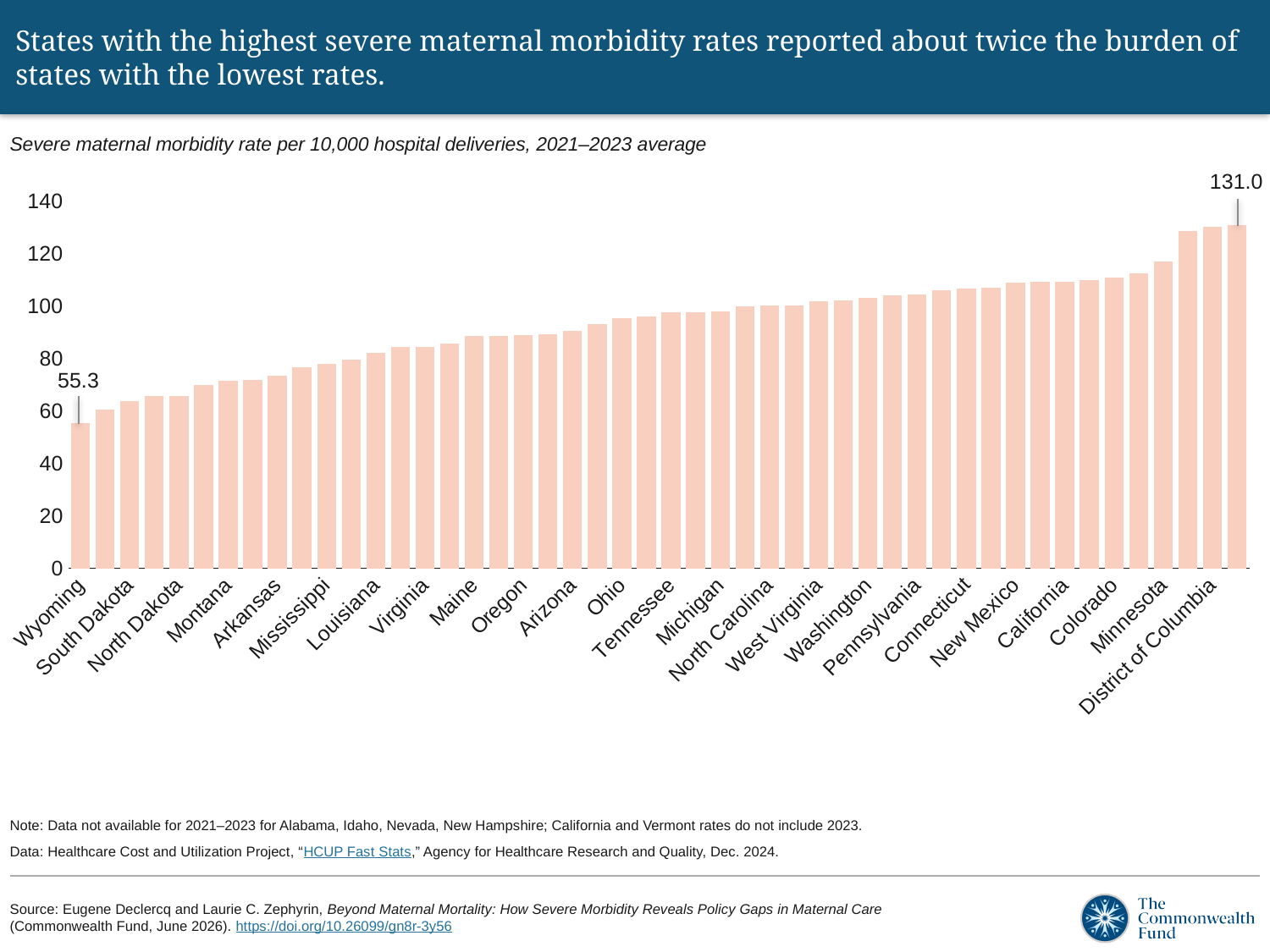
Which has a higher severe maternal morbidity rate, Minnesota or Montana? Minnesota Is the value for Ohio greater or less than 100? less What kind of chart is shown on the slide? Bar chart What unit is the severe maternal morbidity rate measured in, according to the chart subtitle? Per 10,000 hospital deliveries Which state has the lowest severe maternal morbidity rate on the chart? Wyoming Do the values rise or fall moving from left to right along the x axis? Rise What is the severe maternal morbidity rate for Wyoming? 55.3 Is the value for Arkansas greater or less than 80? less